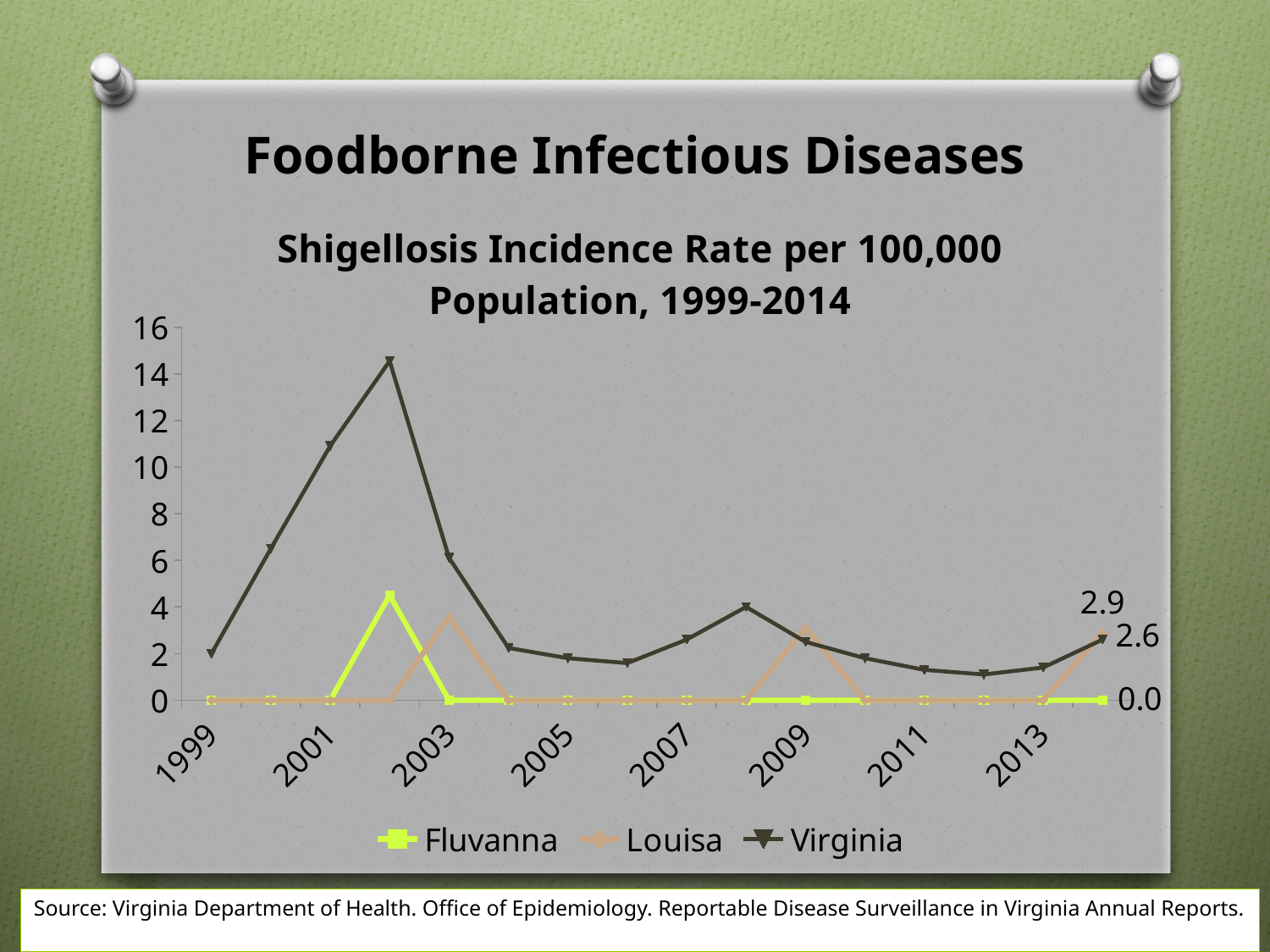
What kind of chart is shown on the slide? line chart Does the Virginia series rise or fall from 2002 to 2004? fall How many series does the legend list? 3 Which series reaches the highest value anywhere on the chart? Virginia Is the value for Virginia in 2002 greater or less than 12? greater In which year does the Virginia series reach its highest value? 2002 What is the Shigellosis incidence rate for Fluvanna in 2014? 0.0 In 2002, which is larger: the value for Virginia or the value for Fluvanna? Virginia Is the value for Fluvanna in 2002 greater or less than 2? greater How many years (data points) does the chart cover? 16 Is the value for Virginia in 1999 greater or less than 4? less Which series are listed in the legend? Fluvanna, Louisa, Virginia